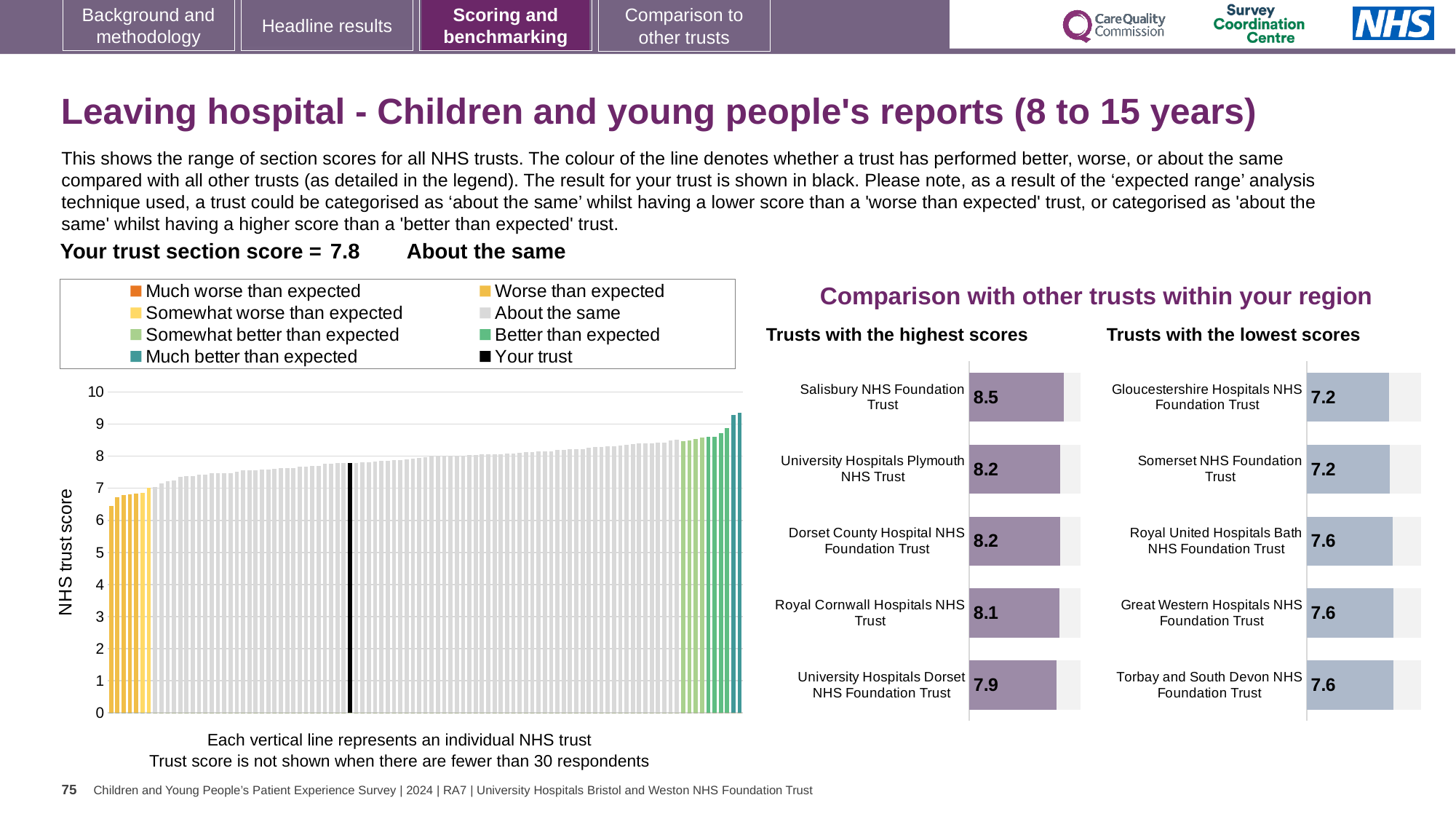
In the main chart of all NHS trusts, is the value for your trust (the black bar) greater or less than 7? greater Which is larger: the score for Royal Cornwall Hospitals NHS Trust in the 'Trusts with the highest scores' chart or the score for Gloucestershire Hospitals NHS Foundation Trust in the 'Trusts with the lowest scores' chart? Royal Cornwall Hospitals NHS Trust In the 'Trusts with the lowest scores' chart, what is the difference between the scores of Torbay and South Devon NHS Foundation Trust and Somerset NHS Foundation Trust? 0.4 How many entries does the legend above the main chart of all NHS trusts list? 8 In the main chart of all NHS trusts, what is the label on the vertical axis? NHS trust score What kind of chart is the main chart showing the range of section scores for all NHS trusts? bar chart In the 'Trusts with the highest scores' chart, how many trusts are shown? 5 In the 'Trusts with the highest scores' chart, what is the difference between the scores of Salisbury NHS Foundation Trust and University Hospitals Dorset NHS Foundation Trust? 0.6 In the 'Trusts with the highest scores' chart, which trust has the highest score? Salisbury NHS Foundation Trust In the main chart of all NHS trusts, what is the section score for your trust? 7.8 In the 'Trusts with the highest scores' chart, what is the score for Salisbury NHS Foundation Trust? 8.5 In the 'Trusts with the lowest scores' chart, what is the score for Royal United Hospitals Bath NHS Foundation Trust? 7.6